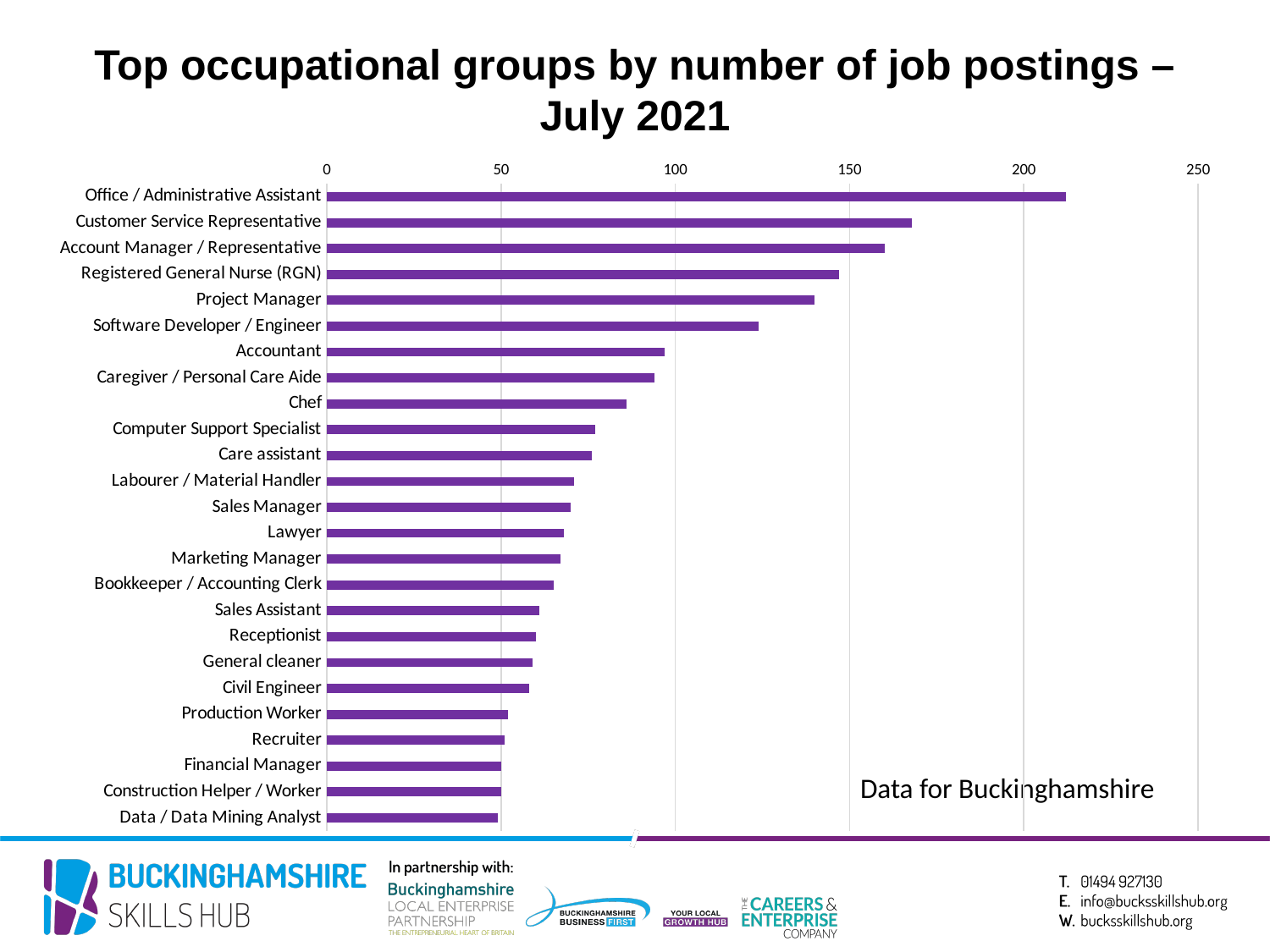
Is the value for Lawyer greater or less than 50? greater How many occupational groups are listed on the chart? 25 What is the title of the chart? Top occupational groups by number of job postings – July 2021 Is the value for Office / Administrative Assistant greater or less than 200? greater Which has more job postings, Project Manager or Software Developer / Engineer? Project Manager Which occupational group has the highest number of job postings? Office / Administrative Assistant Is the value for Software Developer / Engineer greater or less than 100? greater What kind of chart is shown on the slide? Bar chart Which has more job postings, Accountant or Chef? Accountant